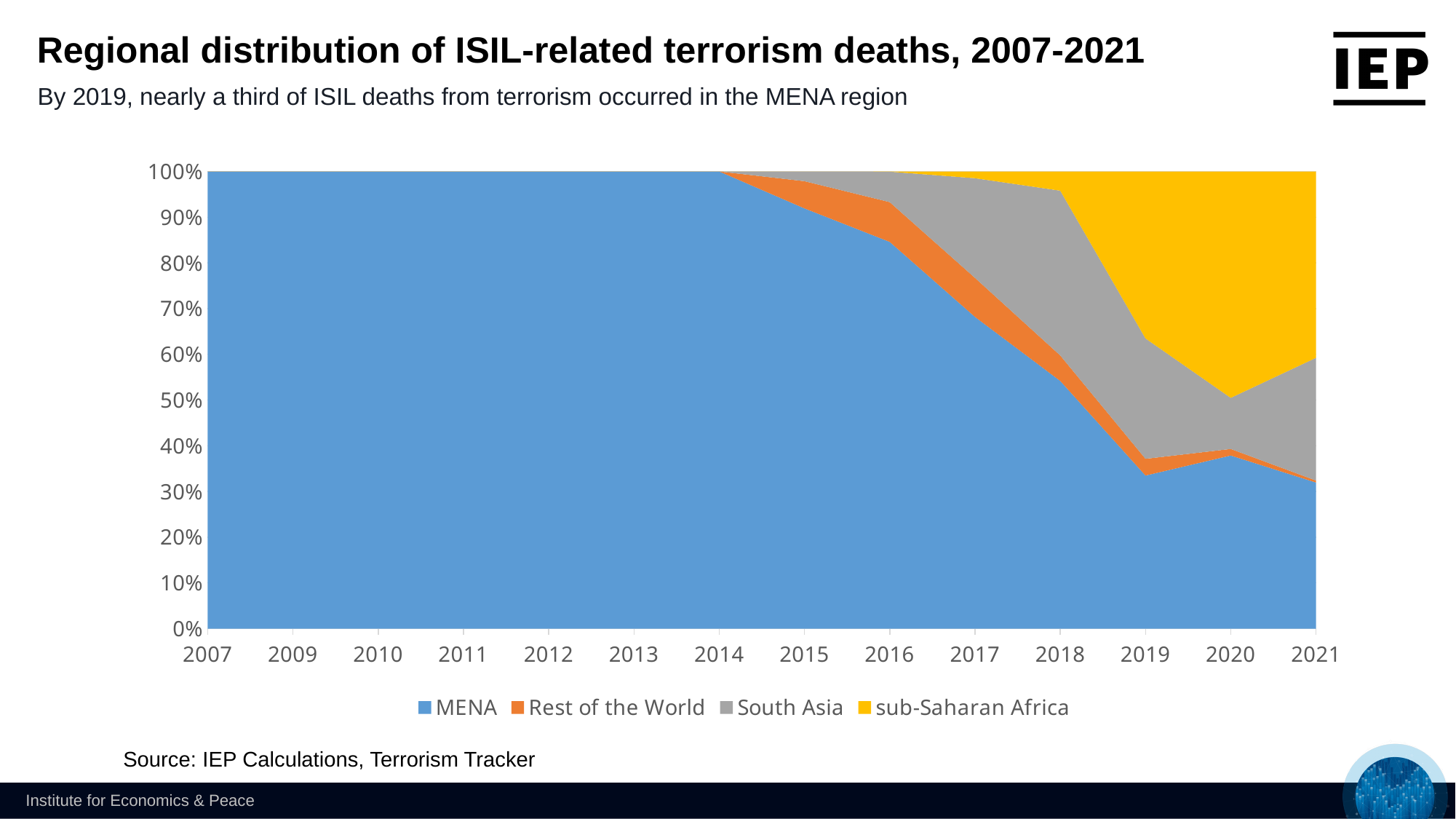
Which colour represents sub-Saharan Africa in the chart? Yellow What kind of chart is shown on the slide? Stacked area chart Is the MENA share in 2019 greater or less than 50%? less In 2018, which region has the larger share: MENA or South Asia? MENA How many years are labelled on the x axis? 14 Does the MENA share of ISIL-related terrorism deaths rise or fall from 2007 to 2021? Fall Which region accounts for the entire share of ISIL-related terrorism deaths in 2007? MENA How many series does the legend list? 4 What is the title of the chart? Regional distribution of ISIL-related terrorism deaths, 2007-2021 In 2020, which region has the larger share: MENA or sub-Saharan Africa? sub-Saharan Africa Is the MENA share in 2021 greater or less than 40%? less Is the MENA share in 2016 greater or less than 80%? greater